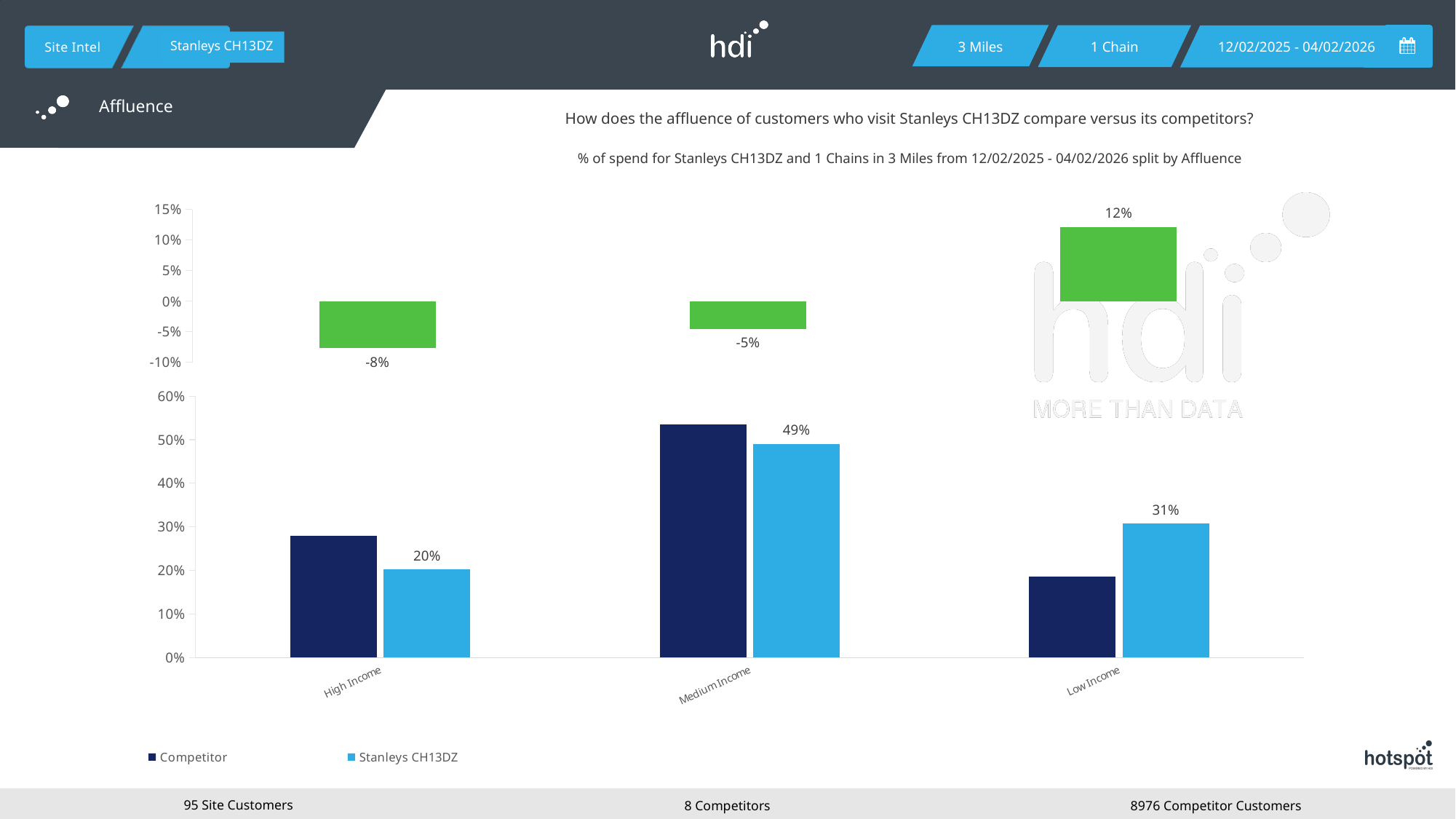
In the bottom bar chart, which category has the highest value for Stanleys CH13DZ? Medium Income In the top difference chart, what is the value shown for the Low Income category? 12% In the bottom bar chart, what is the value for Stanleys CH13DZ in the Medium Income category? 49% In the top difference chart, what is the value shown for the High Income category? -8% How many series does the legend of the bottom bar chart list? 2 In the bottom bar chart, which is larger in the Low Income category: Competitor or Stanleys CH13DZ? Stanleys CH13DZ In the top difference chart, which category has the lowest value? High Income In the bottom bar chart, what is the value for Stanleys CH13DZ in the High Income category? 20% In the bottom bar chart, what is the value for Stanleys CH13DZ in the Low Income category? 31% In the bottom bar chart, what is the difference between the Stanleys CH13DZ values for Medium Income and High Income? 29% In the bottom bar chart, is the Competitor value for Low Income greater or less than 20%? less In the bottom bar chart, is the Competitor value for Medium Income greater or less than 50%? greater